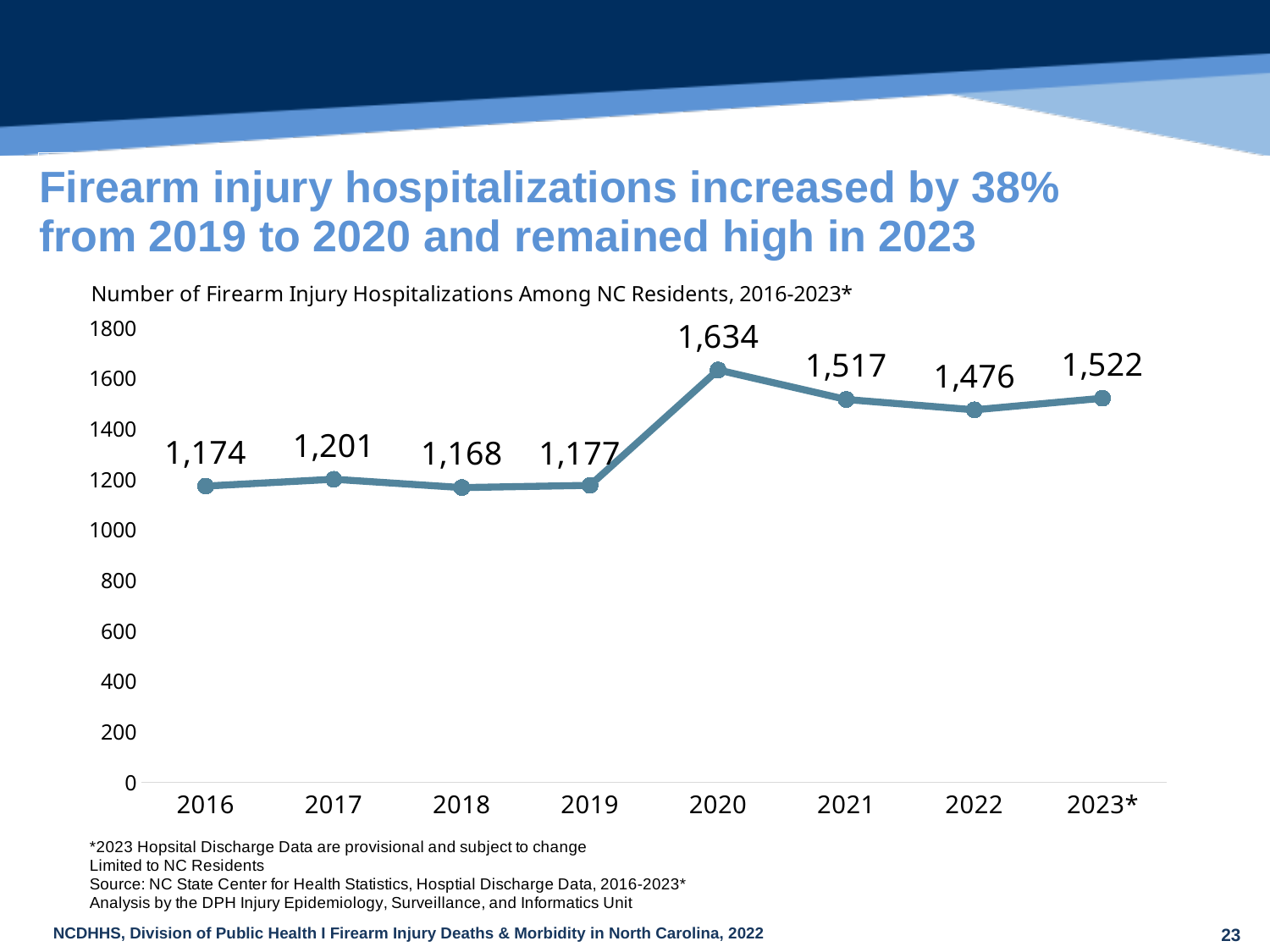
How many years are plotted on the chart? 8 Which year has the highest number of firearm injury hospitalizations? 2020 What is the number of firearm injury hospitalizations in 2020? 1,634 What is the difference in firearm injury hospitalizations between 2021 and 2022? 41 What is the number of firearm injury hospitalizations in 2023*? 1,522 What is the number of firearm injury hospitalizations in 2016? 1,174 What is the difference in firearm injury hospitalizations between 2020 and 2019? 457 Which year had more firearm injury hospitalizations, 2017 or 2022? 2022 Which year has the lowest number of firearm injury hospitalizations? 2018 What kind of chart is shown on the slide? Line chart What is the title of the chart? Number of Firearm Injury Hospitalizations Among NC Residents, 2016-2023* Is the value for 2021 greater or less than 1400? greater